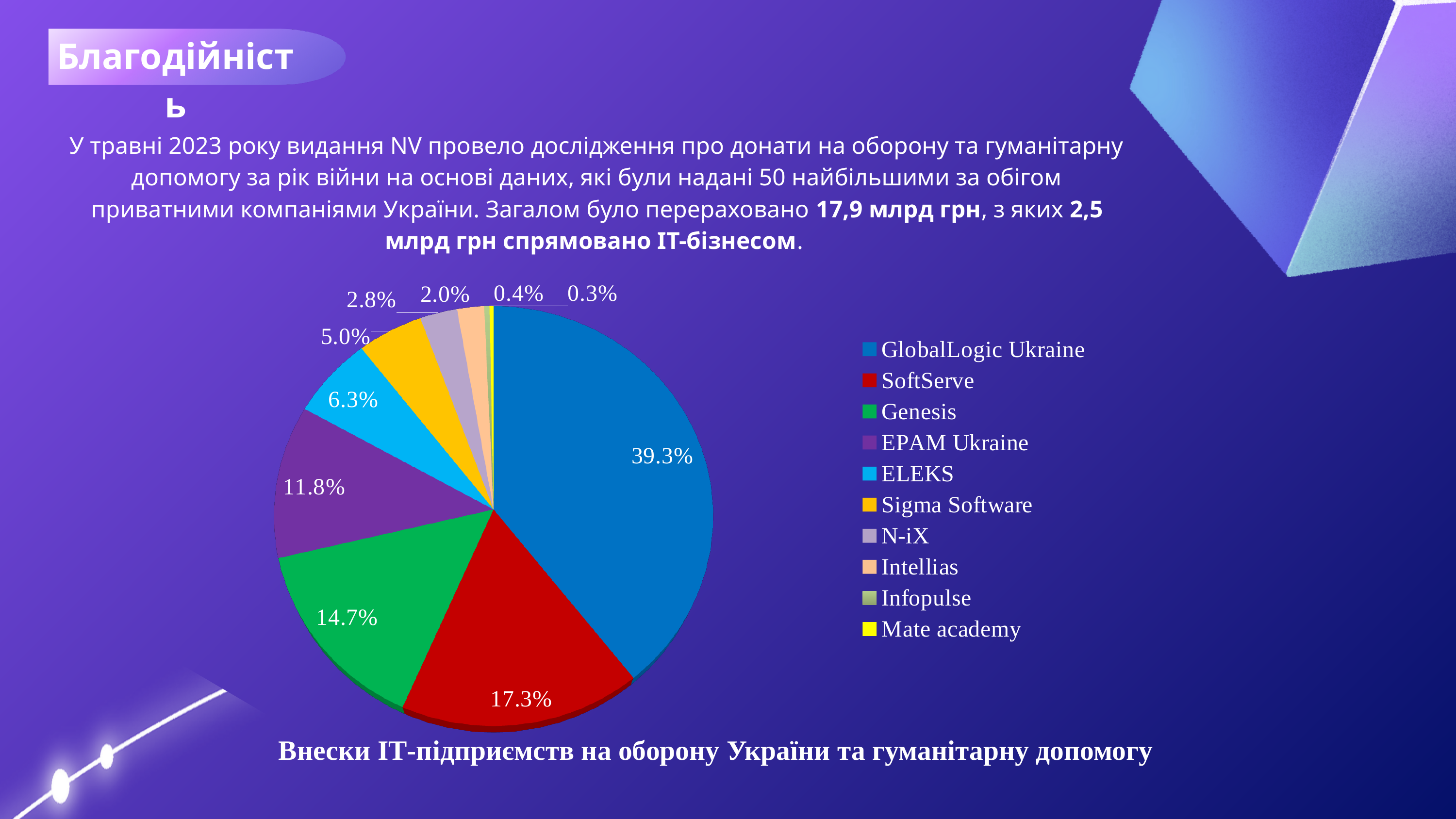
Which company has the largest slice of the pie? GlobalLogic Ukraine What kind of chart is shown on the slide? pie chart Which colour represents ELEKS in the chart? light blue What is the value shown for Sigma Software? 5.0% Which company has the smallest slice of the pie? Mate academy What is the difference between the shares of Genesis and ELEKS? 8.4% What share of the pie does GlobalLogic Ukraine hold? 39.3% What is the value shown for SoftServe? 17.3% What is the title of the chart? Внески ІТ-підприємств на оборону України та гуманітарну допомогу What is the value shown for EPAM Ukraine? 11.8% Which is larger, the share of SoftServe or the share of Genesis? SoftServe How many companies are listed in the legend? 10